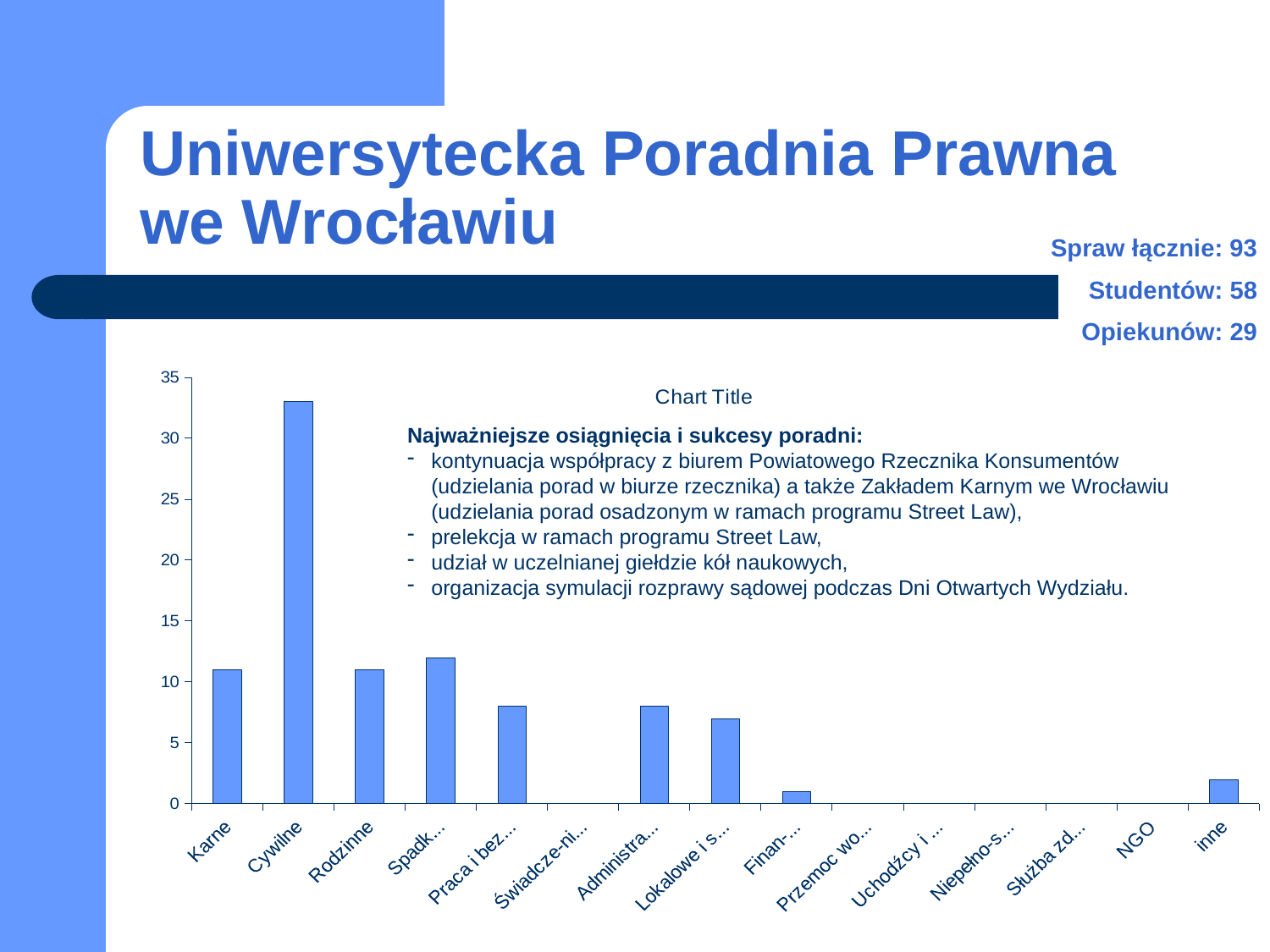
Is the value for Cywilne greater or less than 30? greater Is the value for NGO greater or less than 5? less What is the title shown on the chart? Chart Title Which is larger, the value for Cywilne or the value for Karne? Cywilne How many categories are shown on the x axis of the chart? 15 Which is larger, the value for Karne or the value for inne? Karne What is the highest value shown on the chart's vertical axis? 35 What kind of chart is shown on the slide? bar chart Is the value for inne greater or less than 5? less Which category has the highest bar in the chart? Cywilne